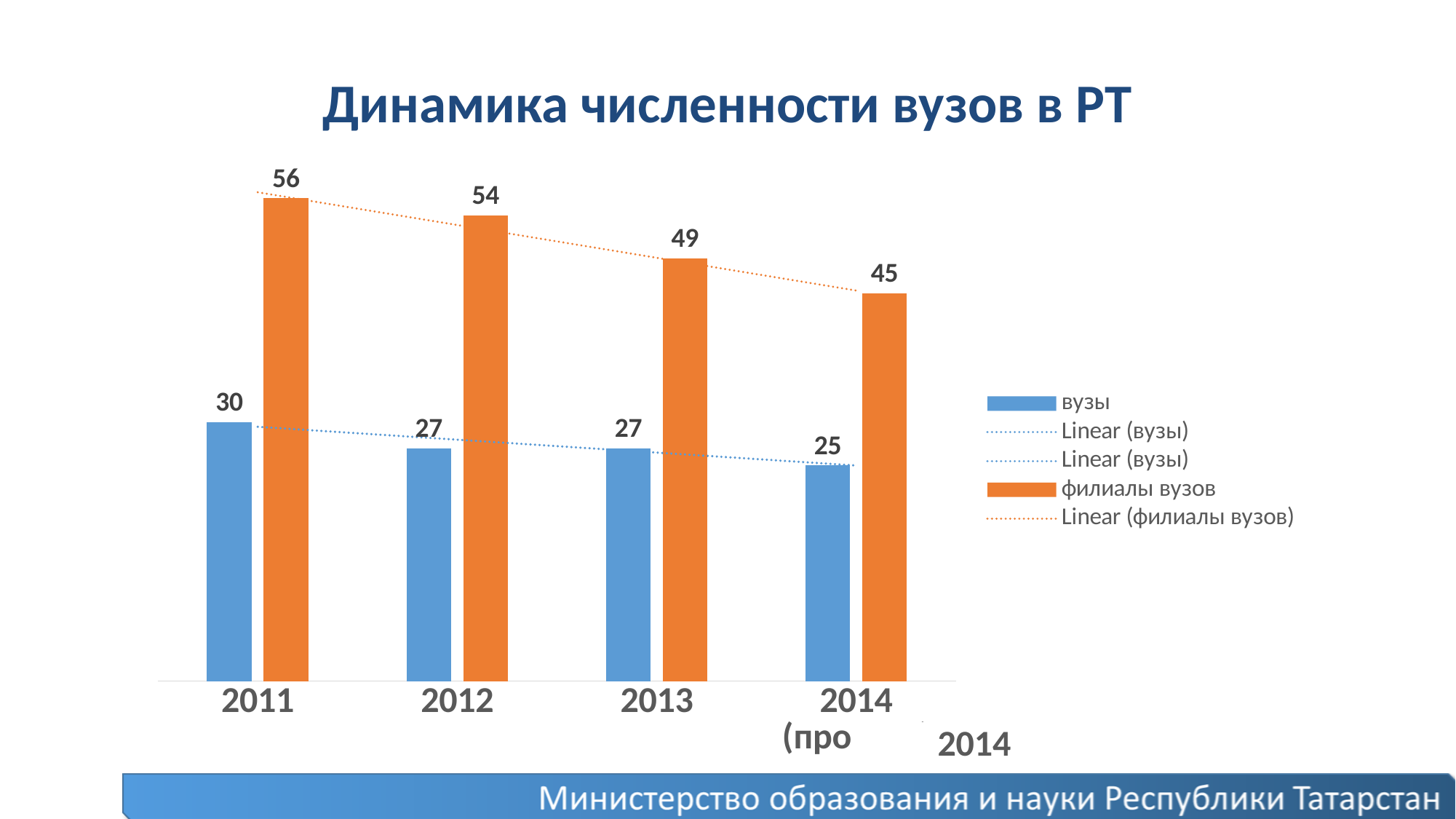
What is the difference between the вузы and филиалы вузов values in 2012? 27 What is the value for вузы in 2011? 30 What is the value for филиалы вузов in 2013? 49 Which is larger in 2013: the value for вузы or the value for филиалы вузов? филиалы вузов What kind of chart is shown on the slide? bar chart What is the value for филиалы вузов in 2014? 45 Do the values for филиалы вузов rise or fall from 2011 to 2014? fall How many years are shown on the x axis? 4 In which year is the value for вузы lowest? 2014 What is the difference between the филиалы вузов values for 2011 and 2014? 11 In which year is the value for филиалы вузов highest? 2011 How many entries does the legend list? 5